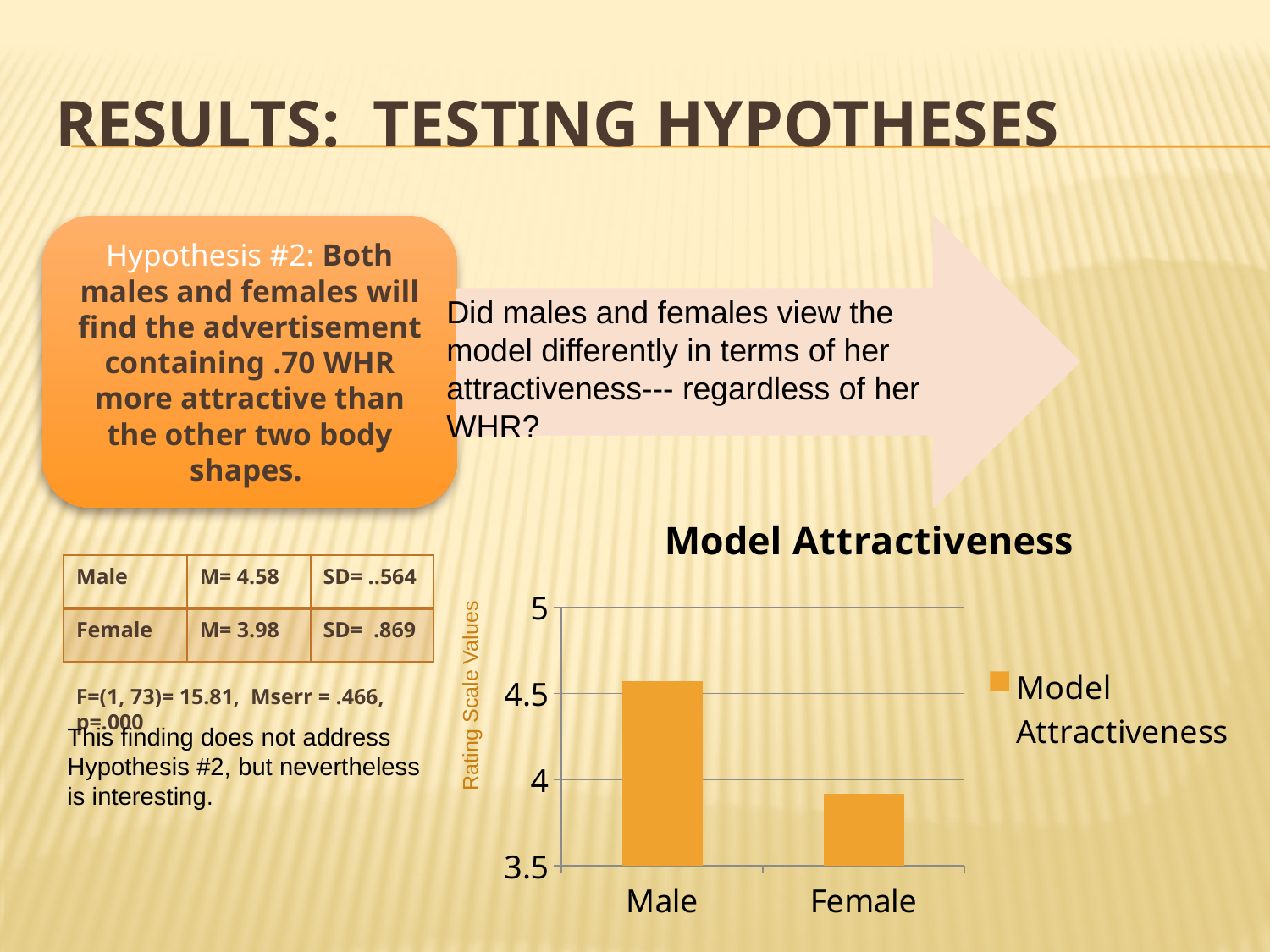
What is the label on the y axis of the chart? Rating Scale Values Is the value for Female greater or less than 3.5? greater What is the title of the chart? Model Attractiveness Do the values fall or rise going from Male to Female along the x axis? fall What kind of chart is shown on the slide? bar chart How many series does the chart's legend list? 1 Is the value for Male greater or less than 4? greater Which category has the lowest bar in the chart? Female How many categories are shown on the x axis of the chart? 2 Which category has the highest bar in the chart? Male Which is larger in the chart, the value for Male or the value for Female? Male Is the value for Female greater or less than 4.5? less